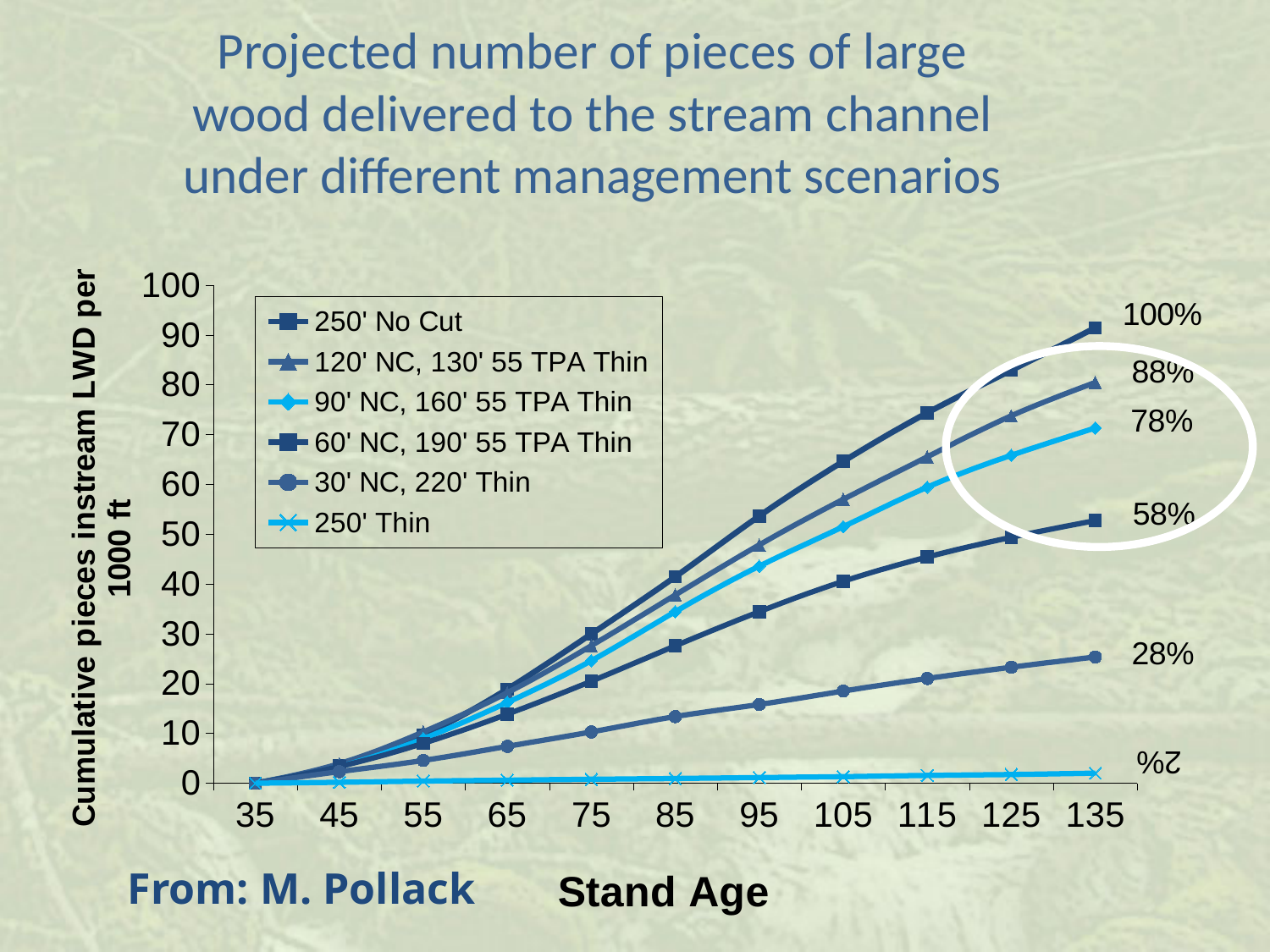
Is the value for 250' No Cut at stand age 135 greater or less than 80? greater Which management scenario has the highest cumulative pieces of instream LWD at stand age 135? 250' No Cut Which management scenario has the lowest cumulative pieces of instream LWD at stand age 135? 250' Thin What is the label of the x axis? Stand Age How many series does the legend list? 6 What kind of chart is shown on the slide? line chart Is the value for 30' NC, 220' Thin at stand age 135 greater or less than 20? greater How many stand age values are marked along the x axis? 11 Do the values for the 250' No Cut series rise or fall as stand age increases? rise What percentage label is printed at the end of the 90' NC, 160' 55 TPA Thin line? 78% At stand age 135, which is larger: the value for 60' NC, 190' 55 TPA Thin or the value for 30' NC, 220' Thin? 60' NC, 190' 55 TPA Thin Is the value for 250' Thin at stand age 135 greater or less than 10? less